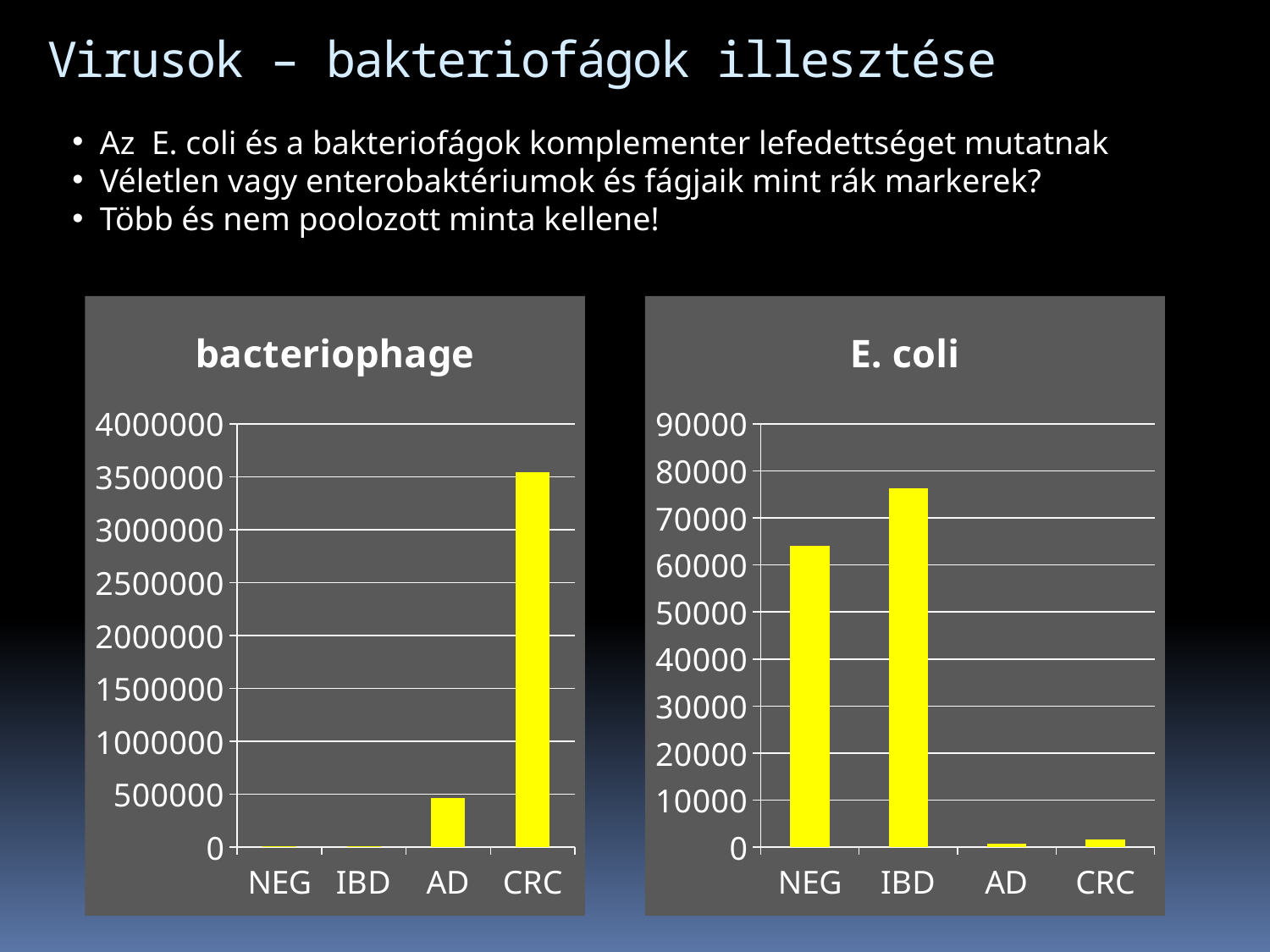
How many categories are shown on the x axis of the "E. coli" chart? 4 What kind of chart is the "bacteriophage" chart? bar chart In the "bacteriophage" chart, is the value for CRC greater or less than 3000000? greater In the "E. coli" chart, which is larger, the value for NEG or the value for IBD? IBD What is the title of the chart on the right side of the slide? E. coli In the "bacteriophage" chart, do the values rise or fall from NEG to CRC along the x axis? rise In the "E. coli" chart, is the value for AD greater or less than 10000? less In the "bacteriophage" chart, which is larger, the value for AD or the value for CRC? CRC In the "E. coli" chart, which category has the highest value? IBD In the "bacteriophage" chart, which category has the highest value? CRC In the "bacteriophage" chart, is the value for AD greater or less than 1000000? less